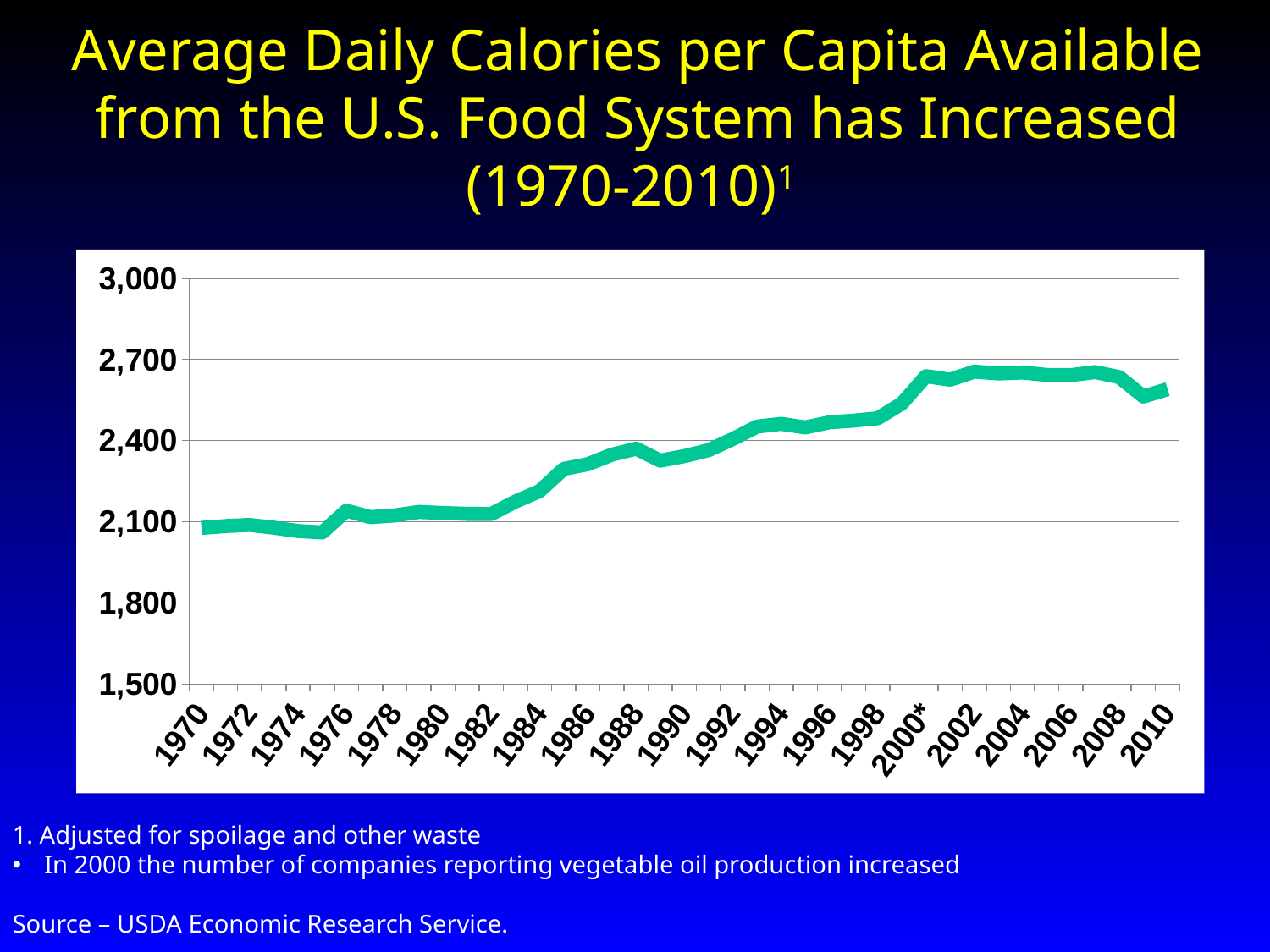
Is the value for 1994 greater or less than 2,400? greater Which year has the larger value, 2008 or 2010? 2008 Which year label on the x axis is marked with an asterisk? 2000 Is the value for 1976 greater or less than 2,100? greater What kind of chart is shown on the slide? line chart Is the value for 1990 greater or less than 2,400? less Overall, do the values rise or fall from 1970 to 2010? rise Which year has the larger value, 1970 or 2010? 2010 How many year labels are shown on the x axis? 21